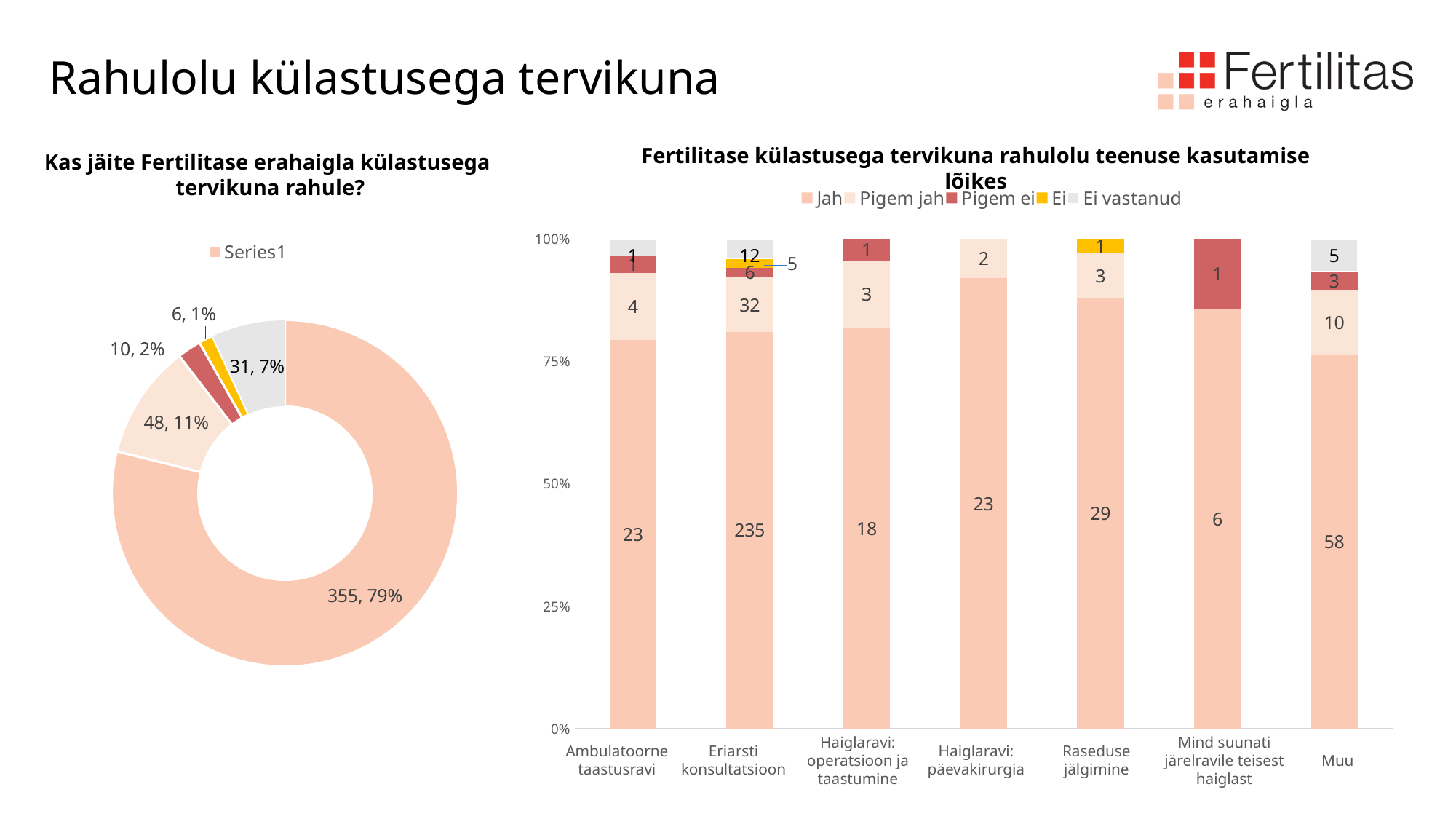
In the chart on the right, what is the difference between the 'Jah' value for Muu and the 'Jah' value for Raseduse jälgimine? 29 In the chart on the right, how many service categories are shown on the x axis? 7 In the chart on the right, is the top of the 'Jah' segment for 'Mind suunati järelravile teisest haiglast' greater or less than 75%? greater What kind of chart is the chart on the right titled 'Fertilitase külastusega tervikuna rahulolu teenuse kasutamise lõikes'? Stacked bar chart In the chart on the right, how many series does the legend list? 5 In the chart on the right, which category has the highest 'Jah' value? Eriarsti konsultatsioon In the donut chart on the left, what share does the largest slice represent? 79% In the chart on the right, what is the 'Jah' value for Eriarsti konsultatsioon? 235 In the chart on the right, what is the 'Pigem jah' value for Eriarsti konsultatsioon? 32 In the chart on the right, which has the larger 'Jah' value: Ambulatoorne taastusravi or Haiglaravi: operatsioon ja taastumine? Ambulatoorne taastusravi In the donut chart on the left, how many slices are there? 5 In the chart on the right, what is the 'Jah' value for Muu? 58